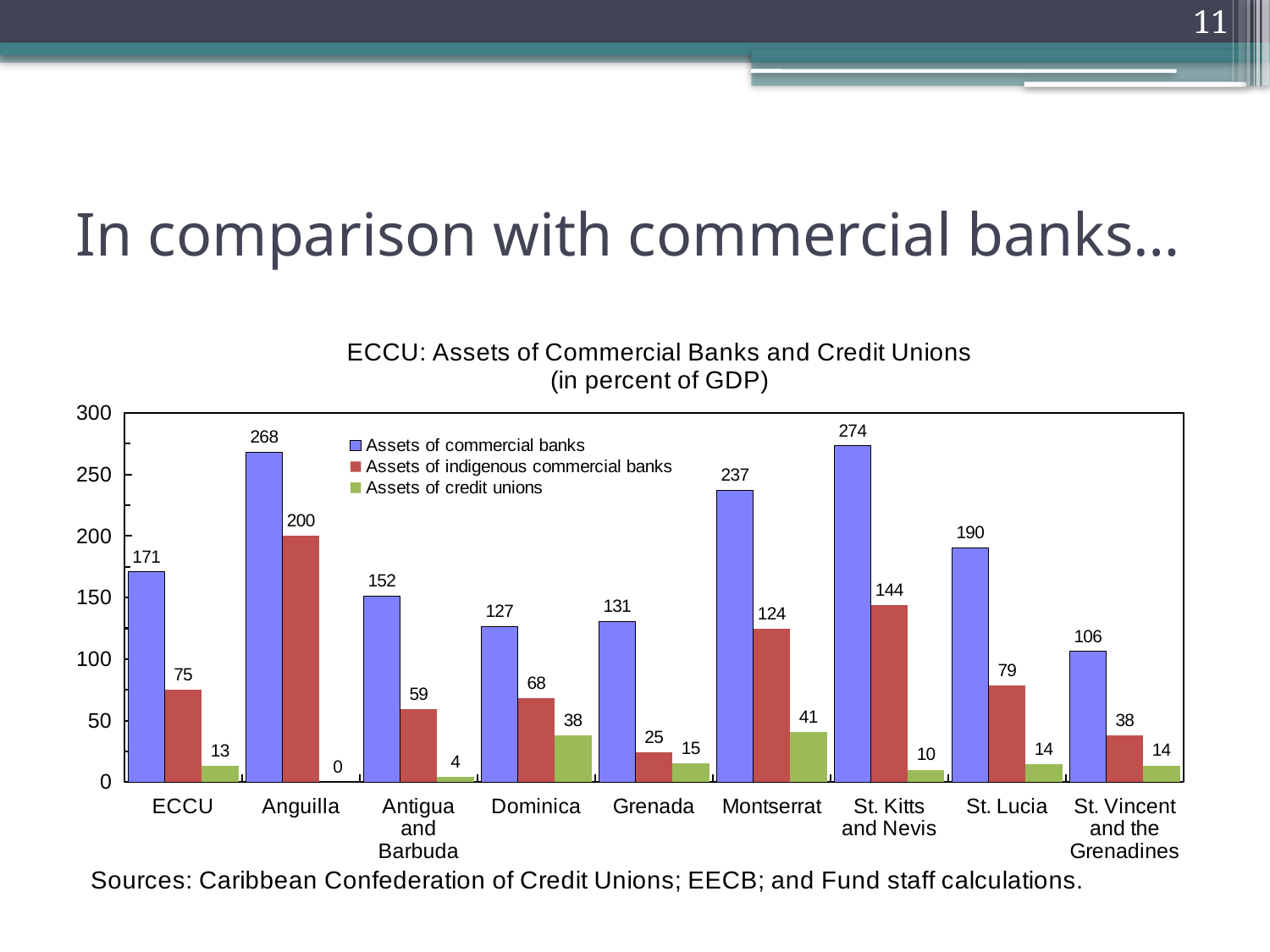
What is the value for Assets of commercial banks in Anguilla? 268 Which category has the highest value for Assets of commercial banks? St. Kitts and Nevis What is the difference between Assets of commercial banks and Assets of indigenous commercial banks in Dominica? 59 What is the value for Assets of indigenous commercial banks in St. Kitts and Nevis? 144 How many categories are shown on the x axis? 9 How many series does the legend list? 3 Which is larger: Assets of credit unions in Antigua and Barbuda or in Grenada? Grenada Which category has the lowest value for Assets of indigenous commercial banks? Grenada What is the value for Assets of credit unions in Montserrat? 41 What kind of chart is shown on the slide? Bar chart What is the title of the chart? ECCU: Assets of Commercial Banks and Credit Unions (in percent of GDP) Which colour represents Assets of credit unions in the chart? Green